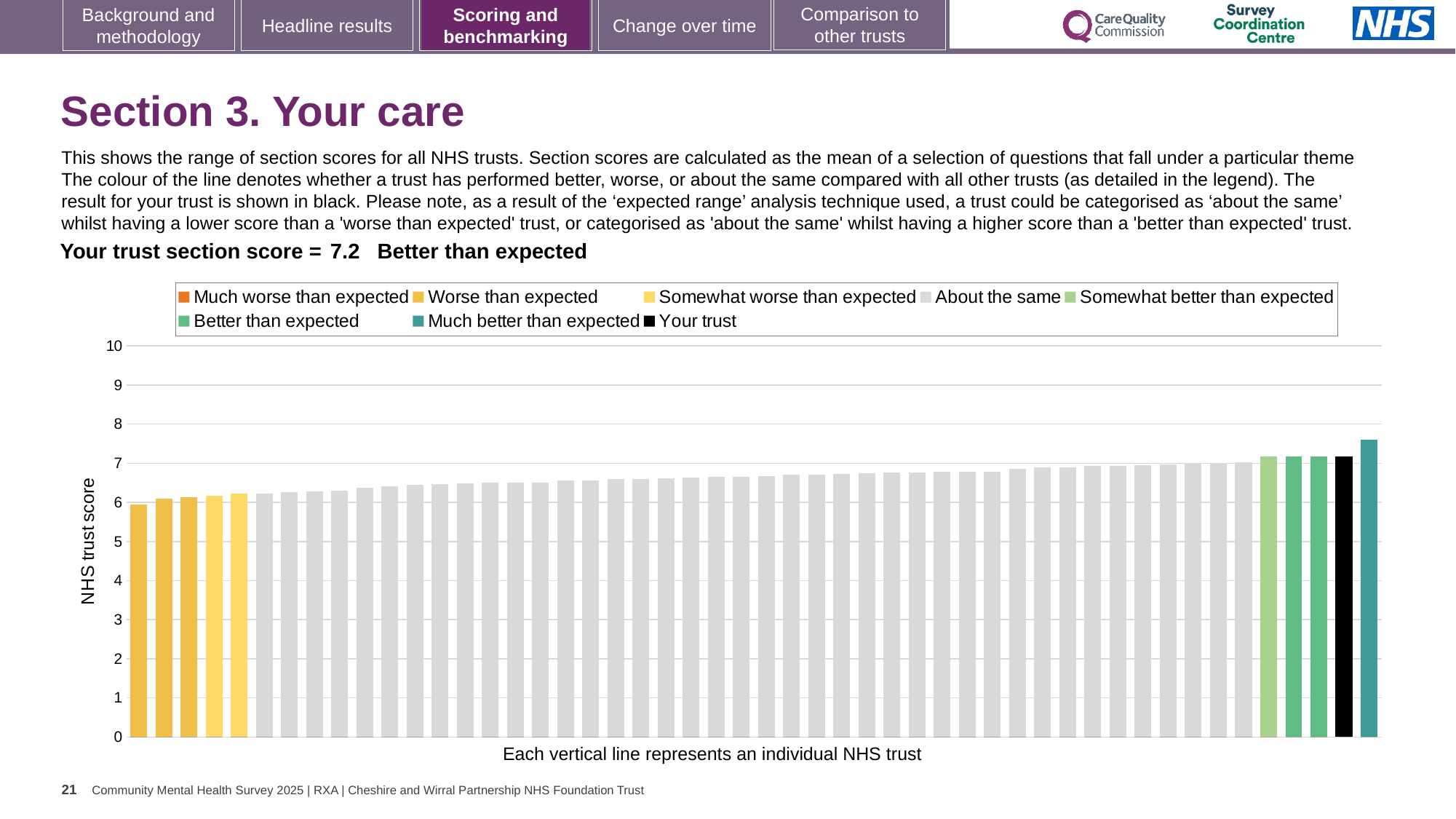
Is the value of the black 'Your trust' bar greater or less than 7? greater What kind of chart is shown on the slide? bar chart Do the bar values rise or fall moving from left to right along the x axis? rise What is the label on the vertical axis of the chart? NHS trust score Which is larger: the black 'Your trust' bar or the rightmost teal bar? the rightmost teal bar What is the section score for your trust shown on the slide? 7.2 How many entries does the chart legend list? 8 Is the value of the leftmost bar greater or less than 7? less Is the value of the tallest bar greater or less than 8? less What colour is the bar representing your trust? black How many bars are coloured black for 'Your trust'? 1